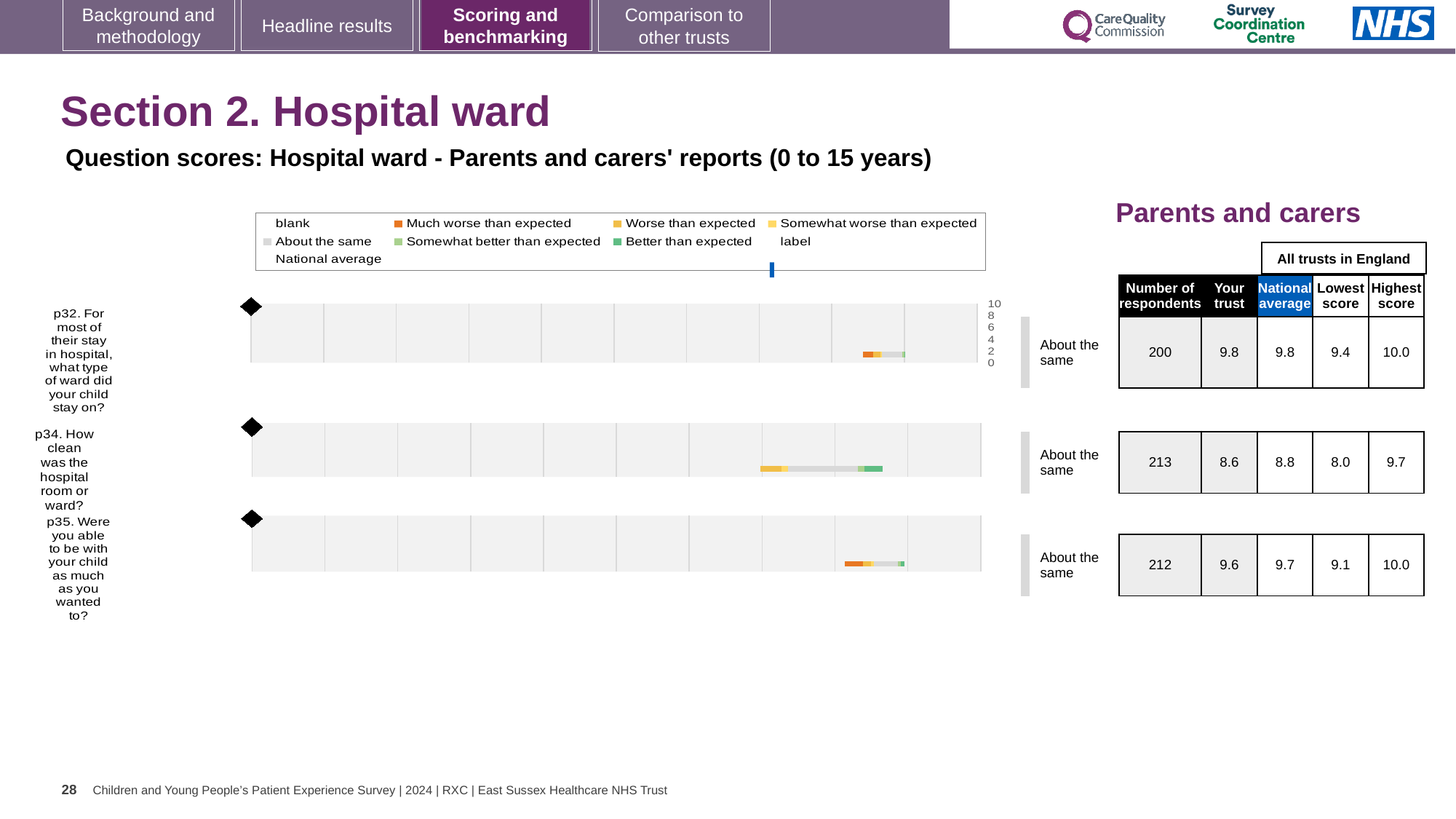
For p34, what is the difference between the highest score and the lowest score across all trusts in England? 1.7 Which question has the highest 'Your trust' score? p32 What kind of chart is used to show the question scores on this slide? Bar chart How many questions (p32, p34, p35) are plotted as separate bars on the slide? 3 For p35, which is larger: the 'Your trust' score or the national average? National average How many respondents are shown for p32 (what type of ward did your child stay on)? 200 Which question has the lowest 'Your trust' score? p34 What is the national average score for p35 (Were you able to be with your child as much as you wanted to)? 9.7 What benchmark category label is shown next to each of the three question bars? About the same What is the 'Your trust' score for p34 (How clean was the hospital room or ward?)? 8.6 How many entries does the chart legend list? 9 What is the lowest score across all trusts in England for p32? 9.4